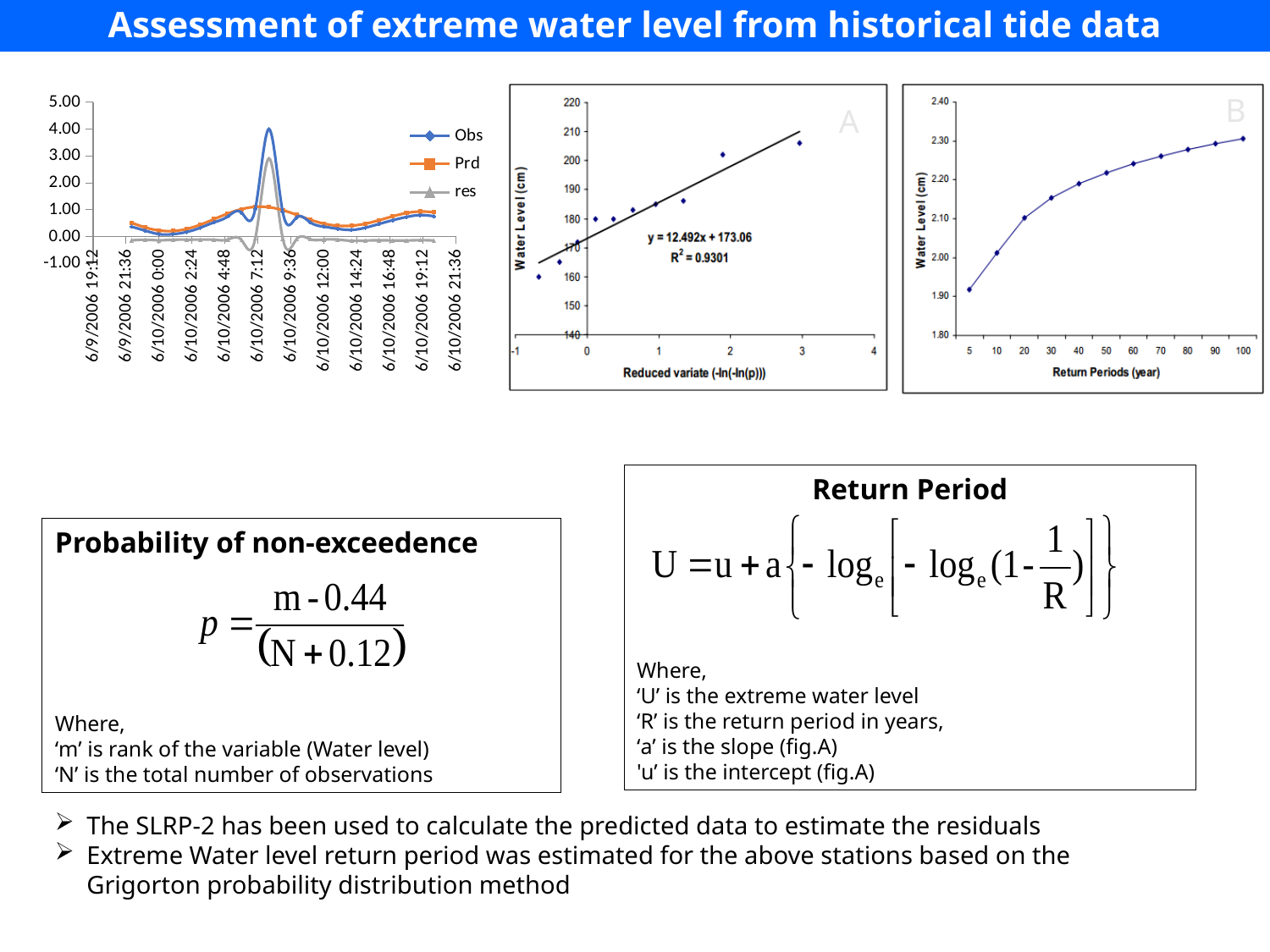
On the left chart, what are the names of the series in the legend? Obs, Prd, res On chart B, is the water level at a return period of 5 years greater or less than 2.00? less What kind of chart is the left chart with the Obs, Prd and res series? line chart On the left chart, is the peak value of the Obs series greater or less than 3.00? greater On chart B, is the water level at a return period of 100 years greater or less than 2.20? greater On the left chart, how many series does the legend list? 3 On the left chart, which series reaches the highest peak? Obs On chart A, what is the R² value shown? 0.9301 On chart A, what is the regression equation shown? y = 12.492x + 173.06 On chart A, do the water level values rise or fall as the reduced variate increases? rise On chart B, do the water level values rise or fall as the return period increases? rise